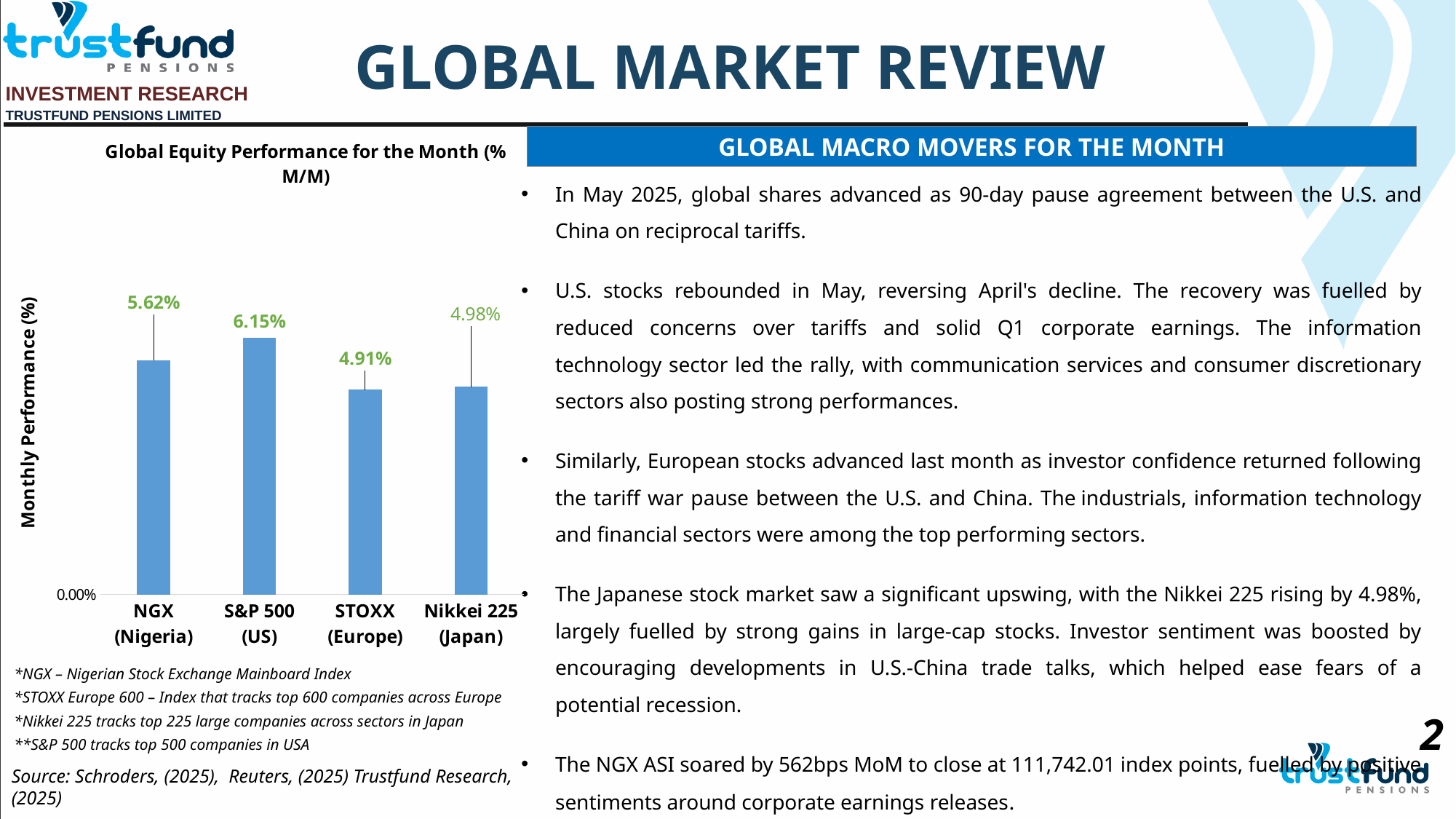
Which has the larger monthly performance, NGX (Nigeria) or STOXX (Europe)? NGX (Nigeria) Which index has the highest monthly performance in the chart? S&P 500 (US) What is the monthly performance value shown for STOXX (Europe)? 4.91% What is the monthly performance value shown for Nikkei 225 (Japan)? 4.98% What is the monthly performance value shown for S&P 500 (US)? 6.15% How many indices are plotted in the chart? 4 What is the title of the chart? Global Equity Performance for the Month (% M/M) What kind of chart is used to show the global equity performance? Bar chart What is the difference between the monthly performance of S&P 500 (US) and NGX (Nigeria)? 0.53% Which index has the lowest monthly performance in the chart? STOXX (Europe) What is the label on the vertical axis of the chart? Monthly Performance (%) What is the monthly performance value shown for NGX (Nigeria)? 5.62%